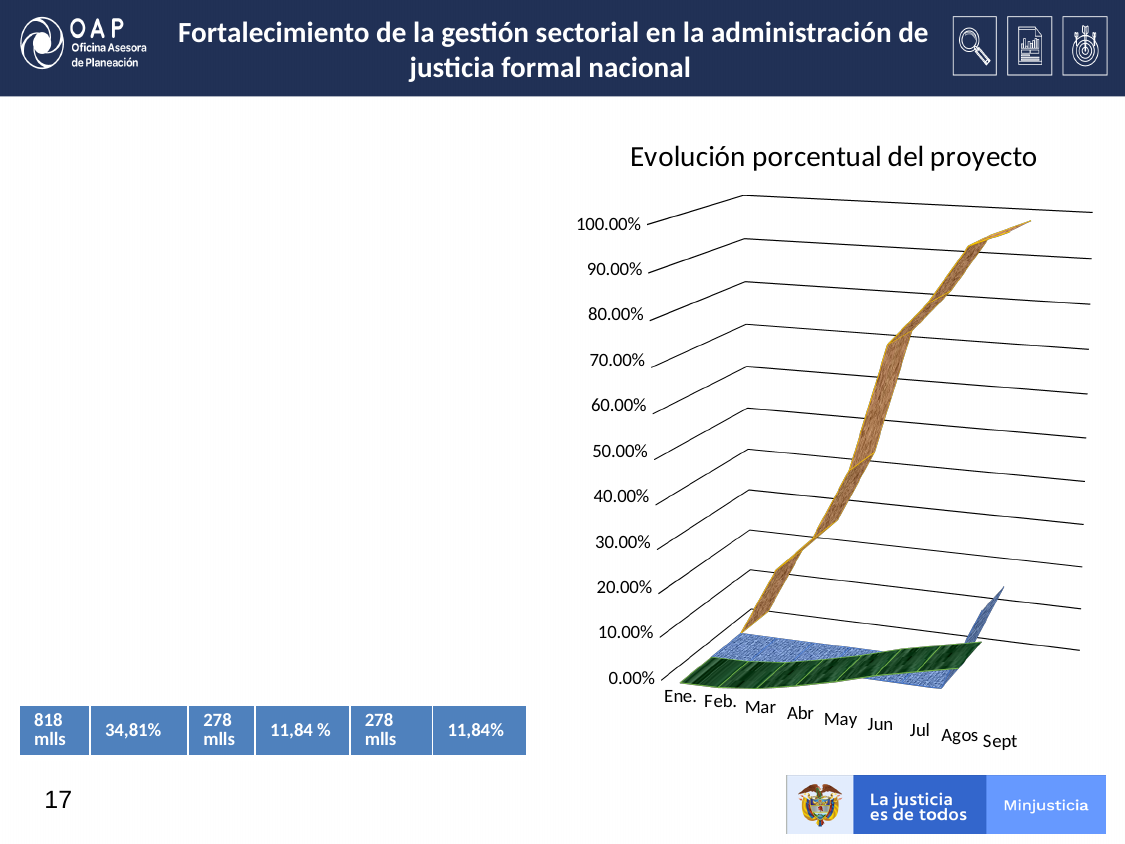
What is the title of the chart? Evolución porcentual del proyecto What is the highest value shown on the y axis of the chart? 100.00% In which month does the upper (orange) series reach its highest value? Agos What kind of chart is shown on the slide? line chart Is the value of the upper (orange) series at Ene. greater or less than 20.00%? less How many months are shown on the x axis of the chart? 9 Does the upper (orange) series rise or fall from Ene. to Sept? rises What is the first category on the x axis of the chart? Ene. Is the value of the lower (green) series at Ene. greater or less than 10.00%? less What is the last category on the x axis of the chart? Sept